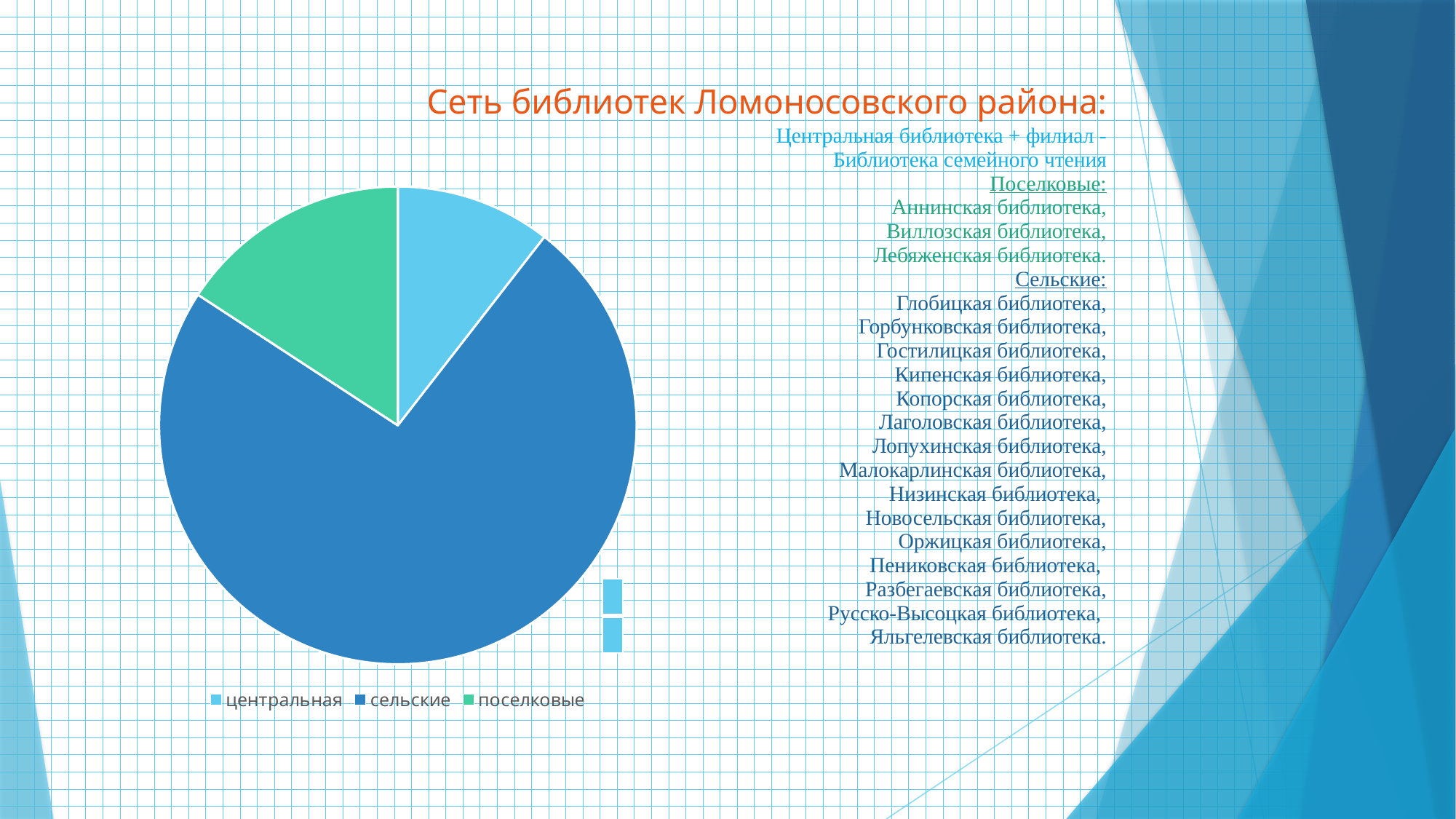
Which category has the smallest slice in the pie chart? центральная Which slice is larger in the pie chart, сельские or поселковые? сельские How many entries does the legend of the pie chart list? 3 What kind of chart is shown on the slide? pie chart Which slice is larger in the pie chart, центральная or сельские? сельские Which slice is larger in the pie chart, центральная or поселковые? поселковые What colour is the сельские slice in the pie chart? dark blue How many slices does the pie chart have? 3 What colour is the поселковые slice in the pie chart? green Which category has the largest slice in the pie chart? сельские